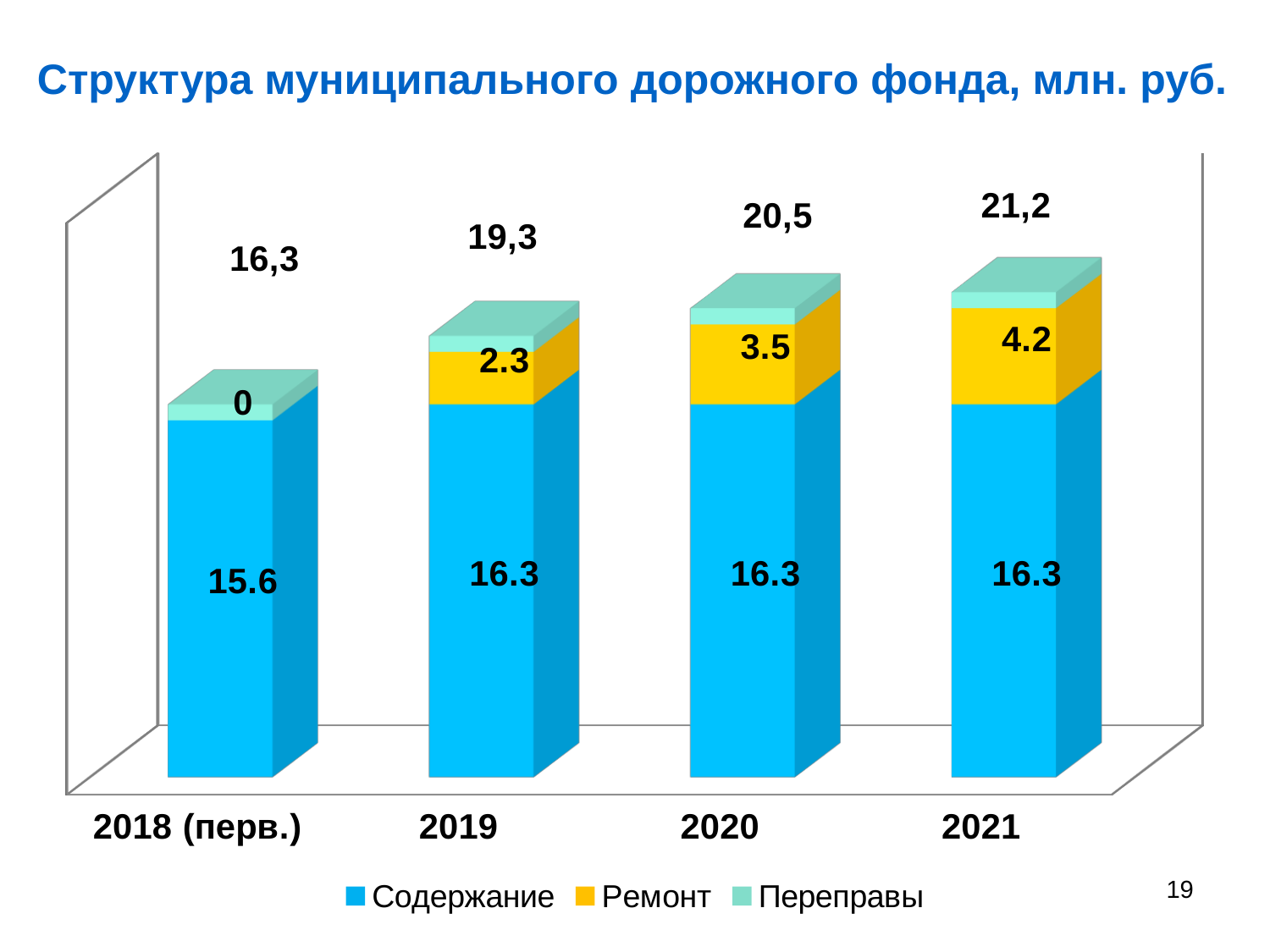
Which year has the highest total? 2021 What is the value of Содержание for 2018 (перв.)? 15.6 What kind of chart is shown on the slide? stacked bar chart What is the value of Ремонт for 2021? 4.2 What is the value of Ремонт for 2020? 3.5 How many series does the legend list? 3 What is the total of the stacked bar for 2021? 21,2 What is the difference between the Ремонт values for 2021 and 2019? 1.9 How many categories (years) are shown on the x axis? 4 Do the bar totals rise or fall from 2018 (перв.) to 2021? rise Which year has the lowest total? 2018 (перв.) What is the total of the stacked bar for 2019? 19,3